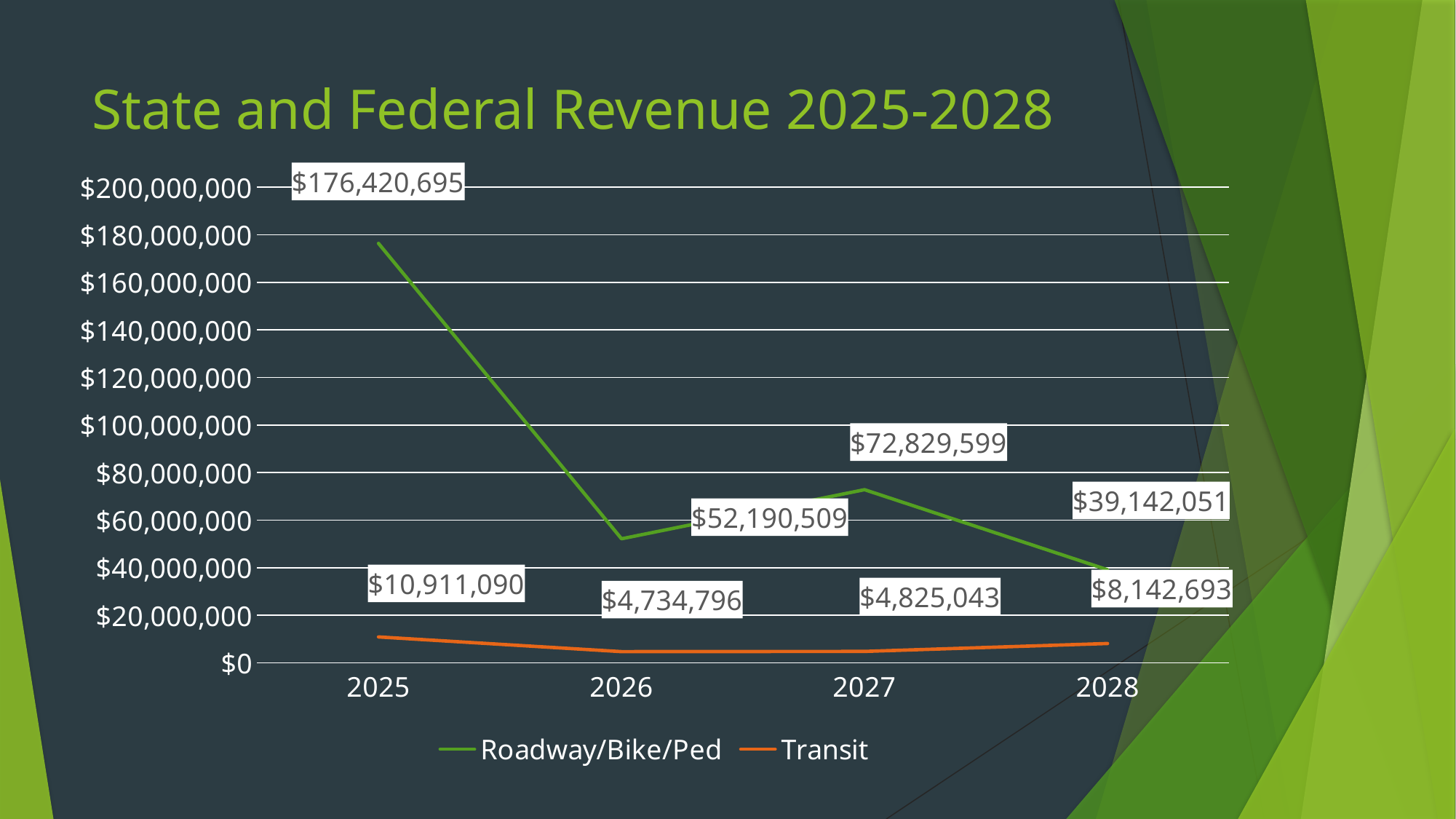
What is the Transit revenue for 2027? $4,825,043 What is the difference between the Transit revenue in 2025 and in 2026? $6,176,294 What is the Transit revenue for 2025? $10,911,090 In which year is the Roadway/Bike/Ped revenue highest? 2025 What type of chart is shown on the slide? line chart What is the difference between the Roadway/Bike/Ped revenue in 2025 and in 2026? $124,230,186 Which is larger in 2027: Roadway/Bike/Ped revenue or Transit revenue? Roadway/Bike/Ped How many years are shown on the x axis? 4 What is the Roadway/Bike/Ped revenue for 2028? $39,142,051 In which year is the Transit revenue lowest? 2026 How many series does the legend list? 2 What is the Roadway/Bike/Ped revenue for 2025? $176,420,695